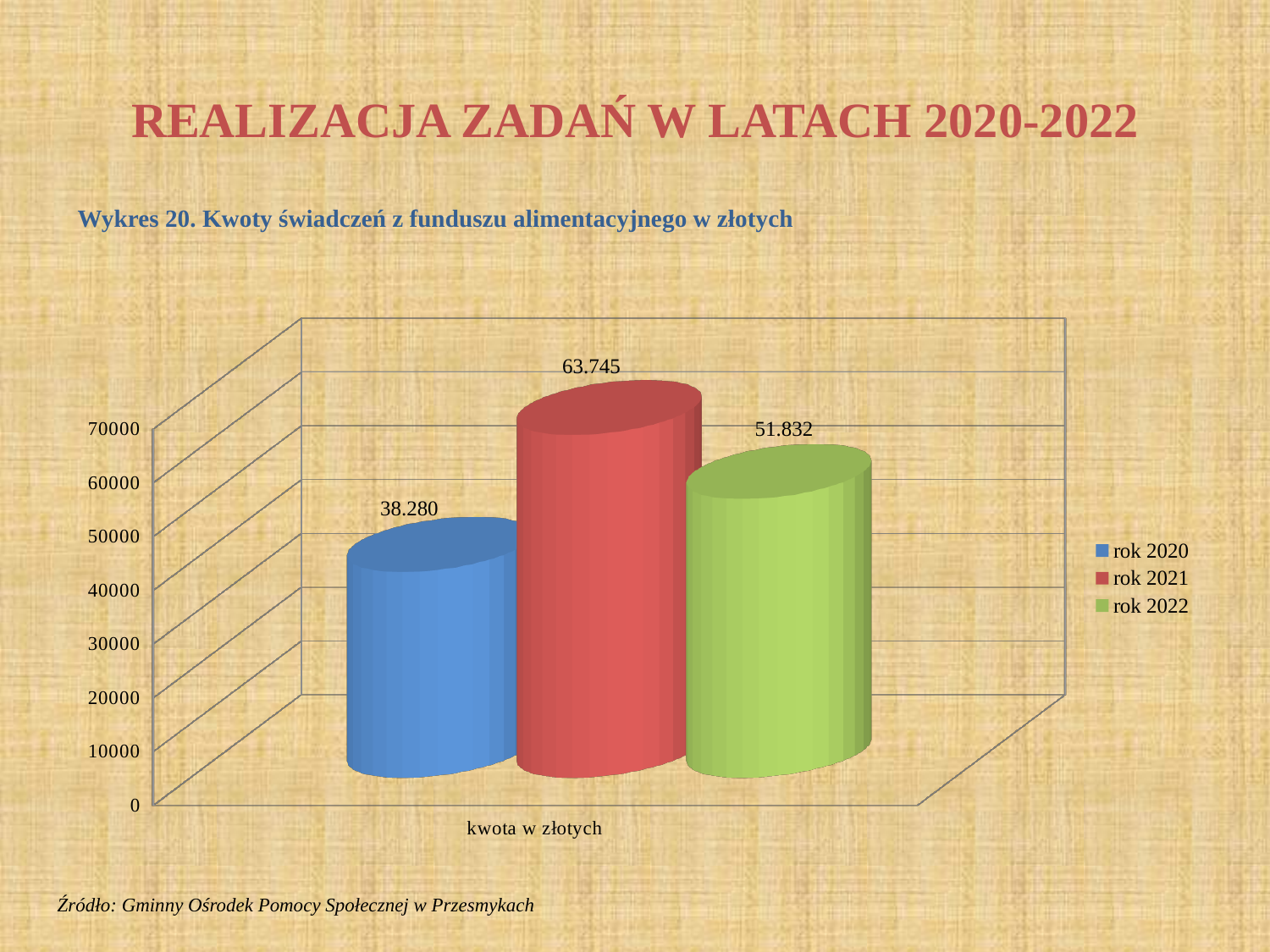
Which is larger, the value for rok 2022 or the value for rok 2020? rok 2022 Is the value for rok 2021 greater or less than 60000? greater What is the value for rok 2021? 63.745 Which year has the highest value? rok 2021 What kind of chart is shown on the slide? bar chart What is the value for rok 2020? 38.280 How many series does the legend list? 3 What is the value for rok 2022? 51.832 What is the difference between the values for rok 2021 and rok 2020? 25.465 What is the title of the chart? Wykres 20. Kwoty świadczeń z funduszu alimentacyjnego w złotych What is the difference between the values for rok 2022 and rok 2020? 13.552 Which year has the lowest value? rok 2020